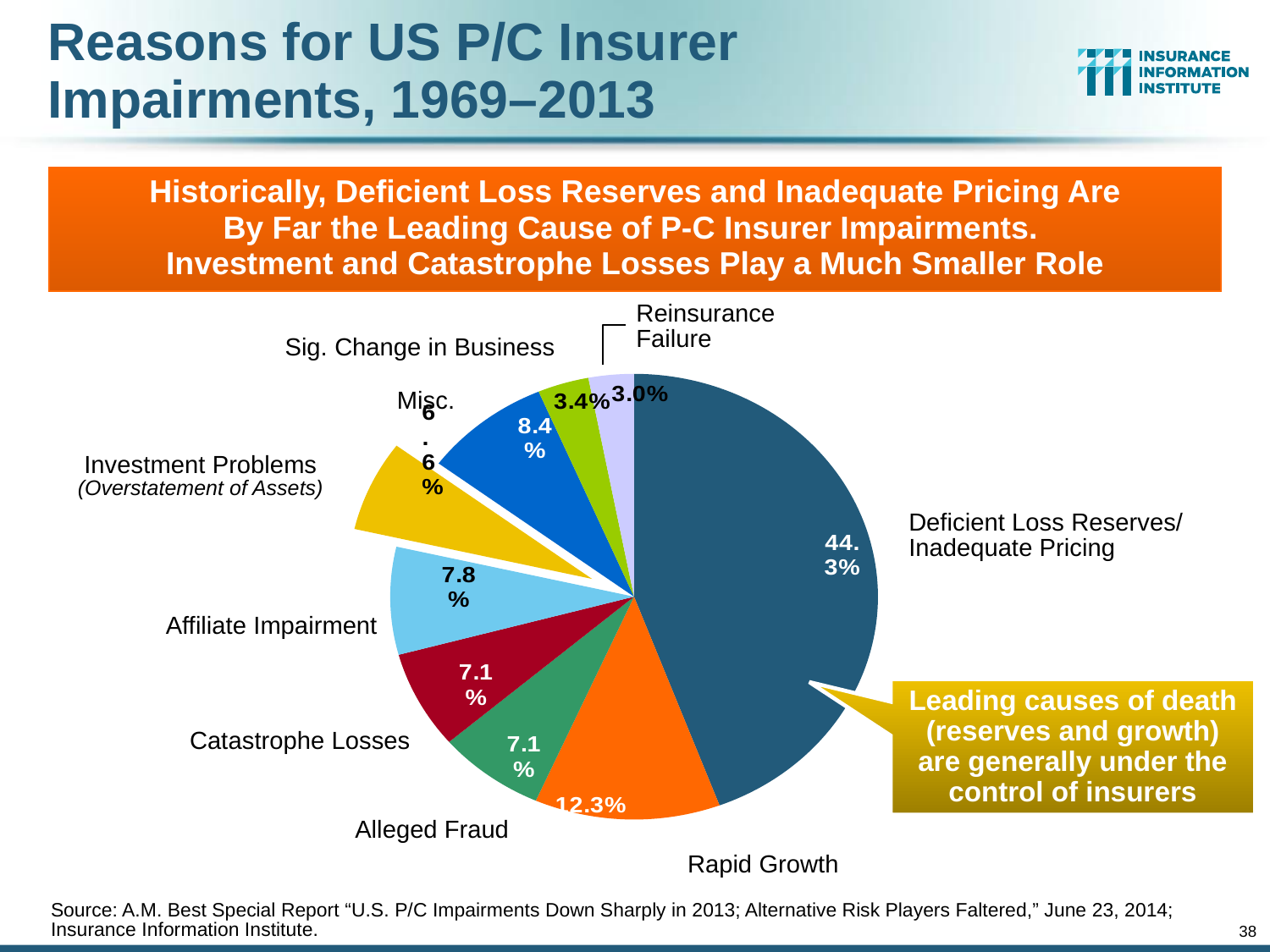
What percentage of impairments is attributed to Misc.? 8.4% How many percentage points larger is the Deficient Loss Reserves/Inadequate Pricing share than the Rapid Growth share? 32.0 percentage points What is the title of the slide containing the pie chart? Reasons for US P/C Insurer Impairments, 1969–2013 How many reasons (slices) are shown in the pie chart? 9 What percentage of impairments is attributed to Rapid Growth? 12.3% Which has a larger share of impairments, Misc. or Affiliate Impairment? Misc. Which reason accounts for the smallest share of impairments? Reinsurance Failure What percentage of impairments is attributed to Reinsurance Failure? 3.0% Which reason accounts for the largest share of impairments? Deficient Loss Reserves/Inadequate Pricing What share of US P/C insurer impairments is attributed to Deficient Loss Reserves/Inadequate Pricing? 44.3% What type of chart is shown on the slide? Pie chart What percentage of impairments is attributed to Affiliate Impairment? 7.8%